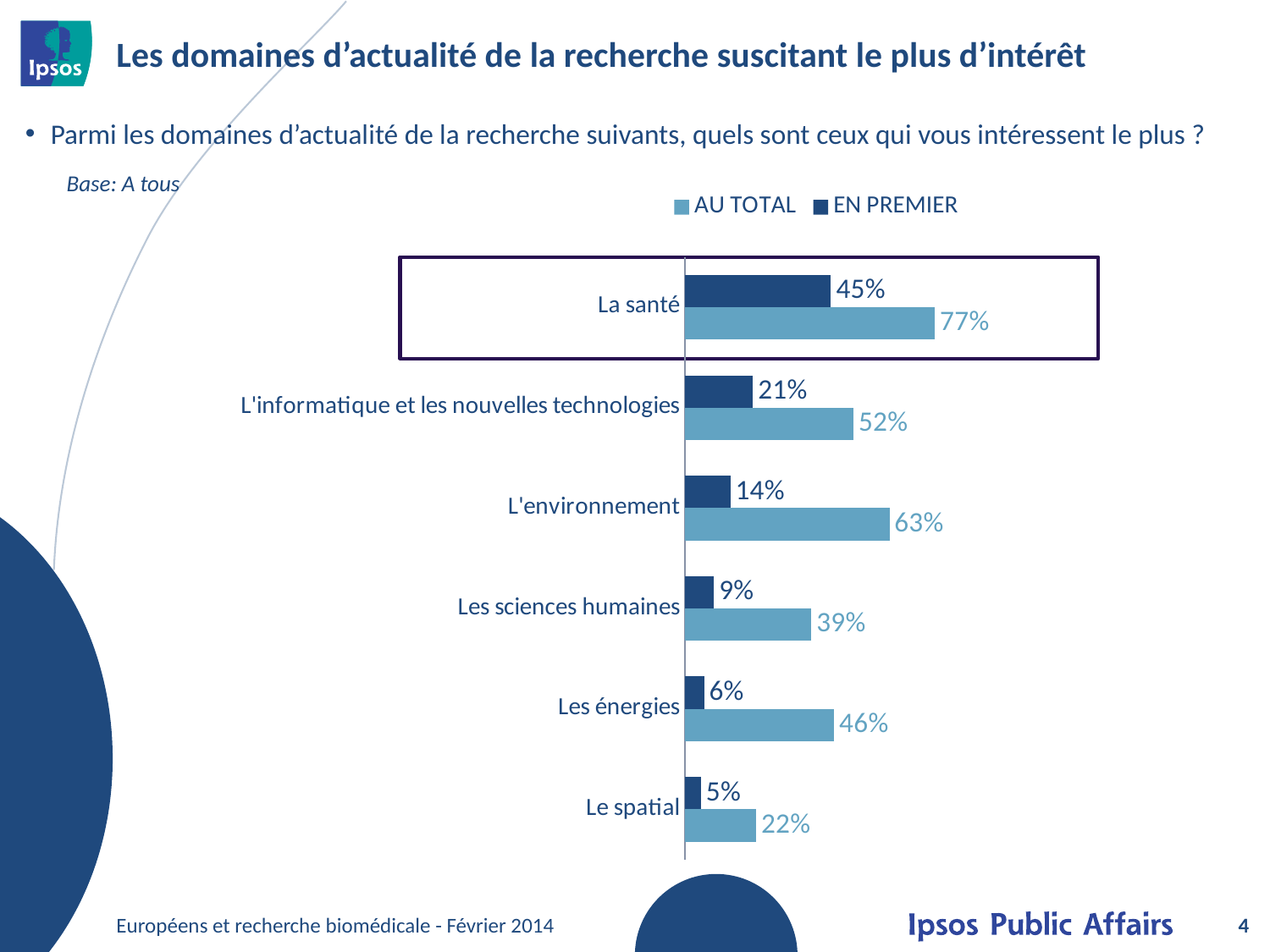
What is the EN PREMIER value for L'informatique et les nouvelles technologies? 21% Which category has the highest AU TOTAL value? La santé How many series does the legend list? 2 What is the EN PREMIER value for Le spatial? 5% How many categories are shown in the chart? 6 Which category is highlighted with a box in the chart? La santé What is the difference between the AU TOTAL and EN PREMIER values for La santé? 32% What is the AU TOTAL value for La santé? 77% What is the AU TOTAL value for L'environnement? 63% Which has a higher AU TOTAL value, Les énergies or Les sciences humaines? Les énergies Which category has the lowest EN PREMIER value? Le spatial What kind of chart is shown on the slide? Bar chart